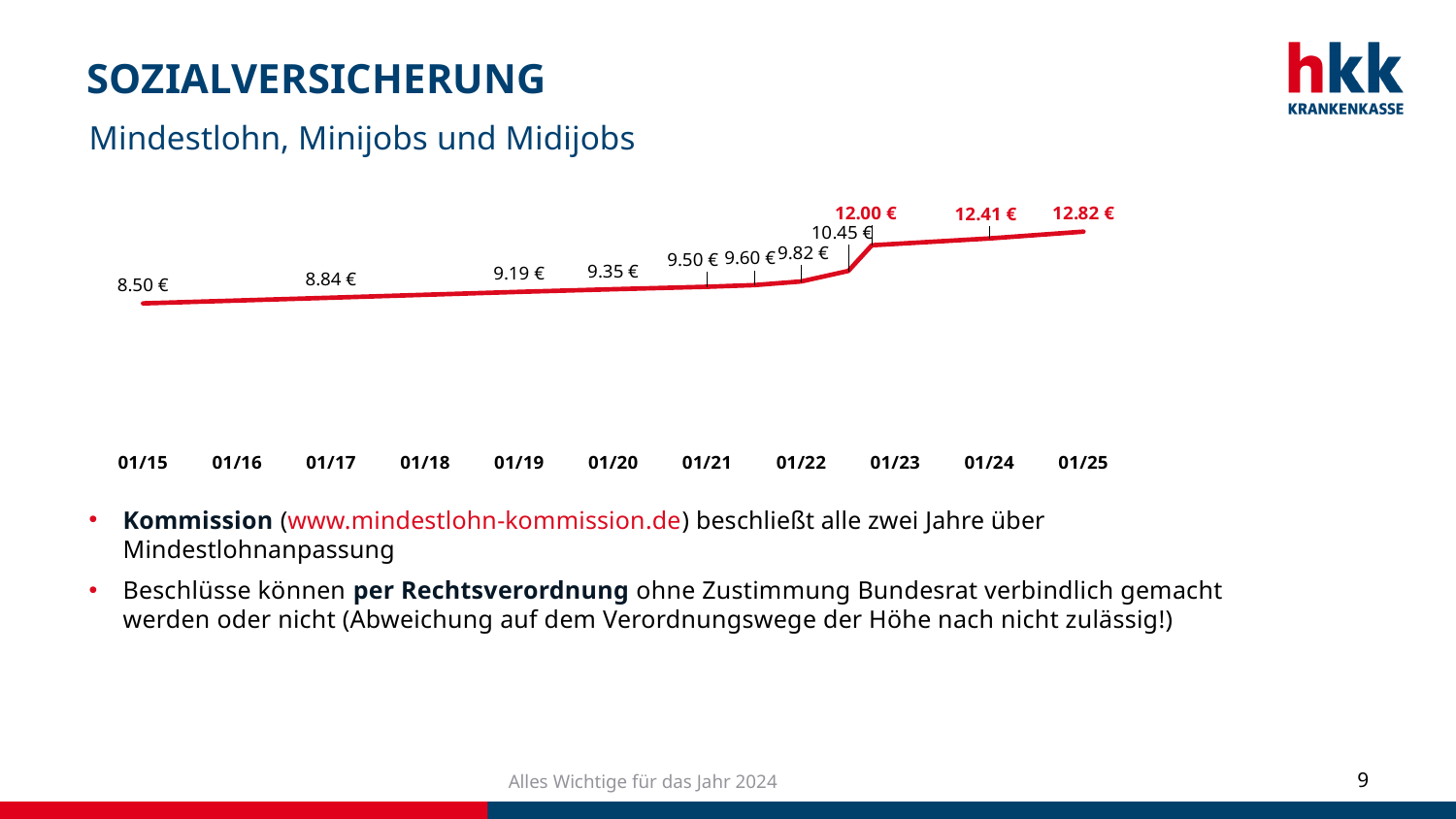
Which is larger, the value labelled 12.00 € or the value labelled 10.45 €? 12.00 € What value is labelled above the 01/24 tick? 12.41 € Do the values rise or fall from 01/15 to 01/25? rise What is the last value shown on the line, at 01/25? 12.82 € What is the first value shown on the line, at 01/15? 8.50 € What value is labelled above the 01/17 tick? 8.84 € What value is labelled above the 01/20 tick? 9.35 € What type of chart is shown on the slide? line chart What is the highest value labelled on the line? 12.82 € What is the difference between the last value (12.82 €) and the first value (8.50 €)? 4.32 € What is the lowest value labelled on the line? 8.50 € How many date labels are shown on the x axis? 11